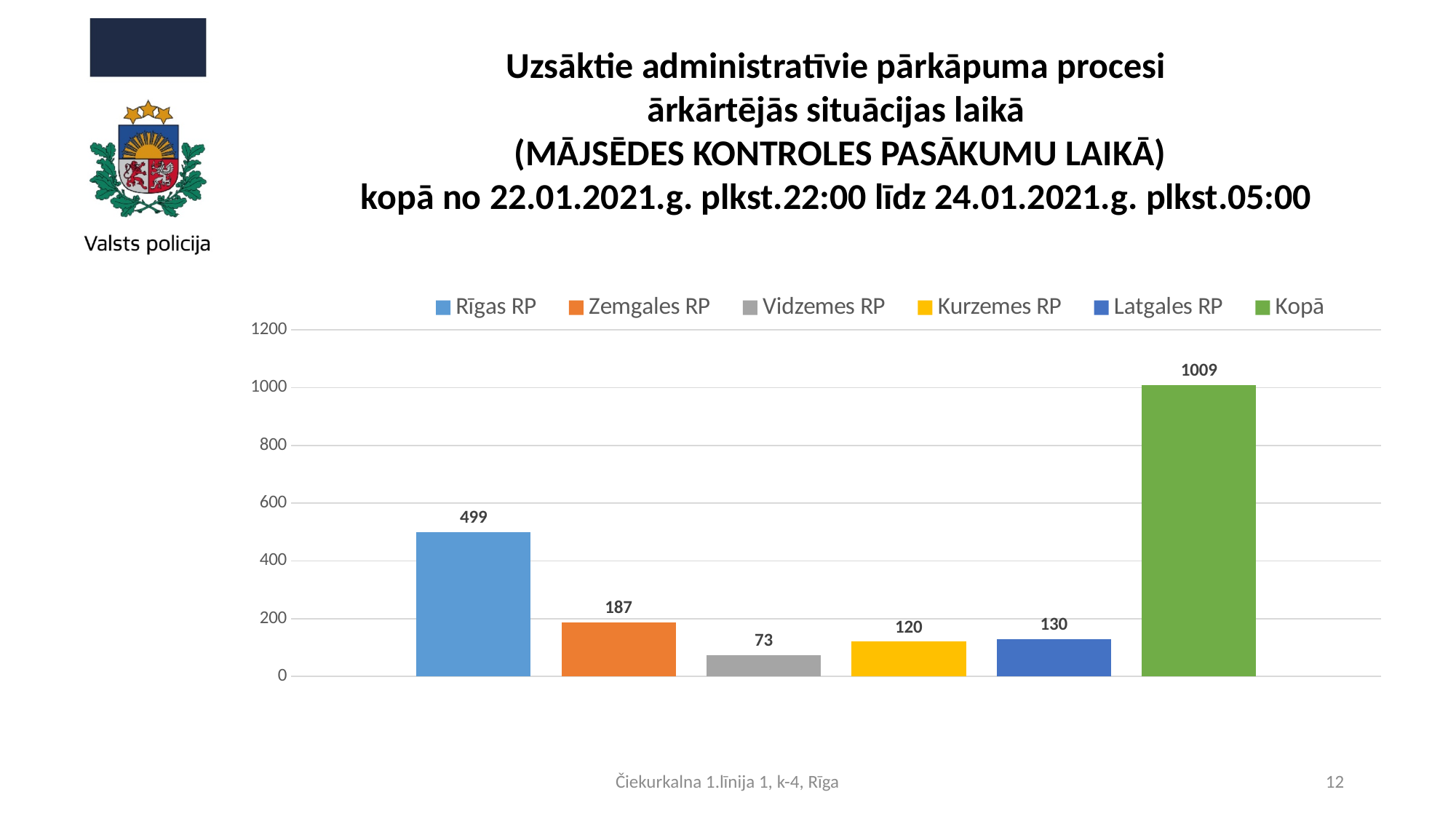
What colour is the bar for Kurzemes RP? yellow Which series has the highest value? Kopā What is the difference between the values for Latgales RP and Kurzemes RP? 10 Which series has the lowest value? Vidzemes RP Which is larger, the value for Zemgales RP or the value for Latgales RP? Zemgales RP What is the value for Vidzemes RP? 73 What is the value for Kopā? 1009 What is the value for Rīgas RP? 499 What is the difference between the values for Rīgas RP and Zemgales RP? 312 Is the value for Rīgas RP greater or less than 400? greater How many series does the legend list? 6 What kind of chart is shown on the slide? bar chart